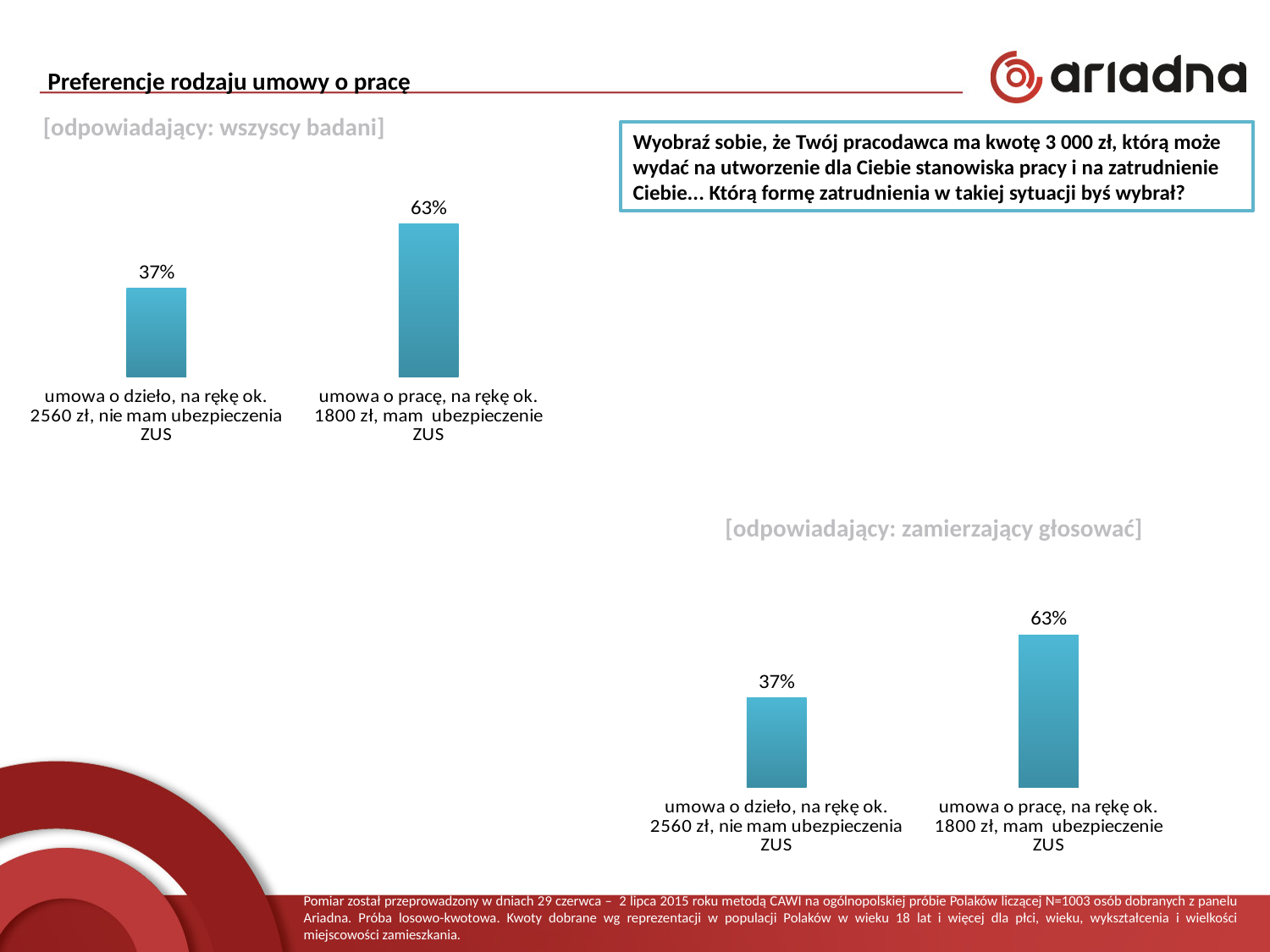
In the bottom-right chart (zamierzający głosować), what is the value for 'umowa o pracę, na rękę ok. 1800 zł, mam ubezpieczenie ZUS'? 63% In the top-left chart (wszyscy badani), which category has the highest value? umowa o pracę, na rękę ok. 1800 zł, mam ubezpieczenie ZUS In the bottom-right chart (zamierzający głosować), what is the value for 'umowa o dzieło, na rękę ok. 2560 zł, nie mam ubezpieczenia ZUS'? 37% What is the total of the two values in the bottom-right chart (zamierzający głosować)? 100% In the top-left chart (wszyscy badani), what is the value for 'umowa o pracę, na rękę ok. 1800 zł, mam ubezpieczenie ZUS'? 63% How many categories are shown in the top-left chart (wszyscy badani)? 2 In the bottom-right chart (zamierzający głosować), which category has the lowest value? umowa o dzieło, na rękę ok. 2560 zł, nie mam ubezpieczenia ZUS In the top-left chart (wszyscy badani), what is the difference between the value for 'umowa o pracę' and the value for 'umowa o dzieło'? 26% In the bottom-right chart (zamierzający głosować), which is larger: the value for 'umowa o dzieło' or the value for 'umowa o pracę'? umowa o pracę In the top-left chart (wszyscy badani), what is the value for 'umowa o dzieło, na rękę ok. 2560 zł, nie mam ubezpieczenia ZUS'? 37% What is the title of the slide containing the two charts? Preferencje rodzaju umowy o pracę What kind of chart is the bottom-right chart (zamierzający głosować)? bar chart